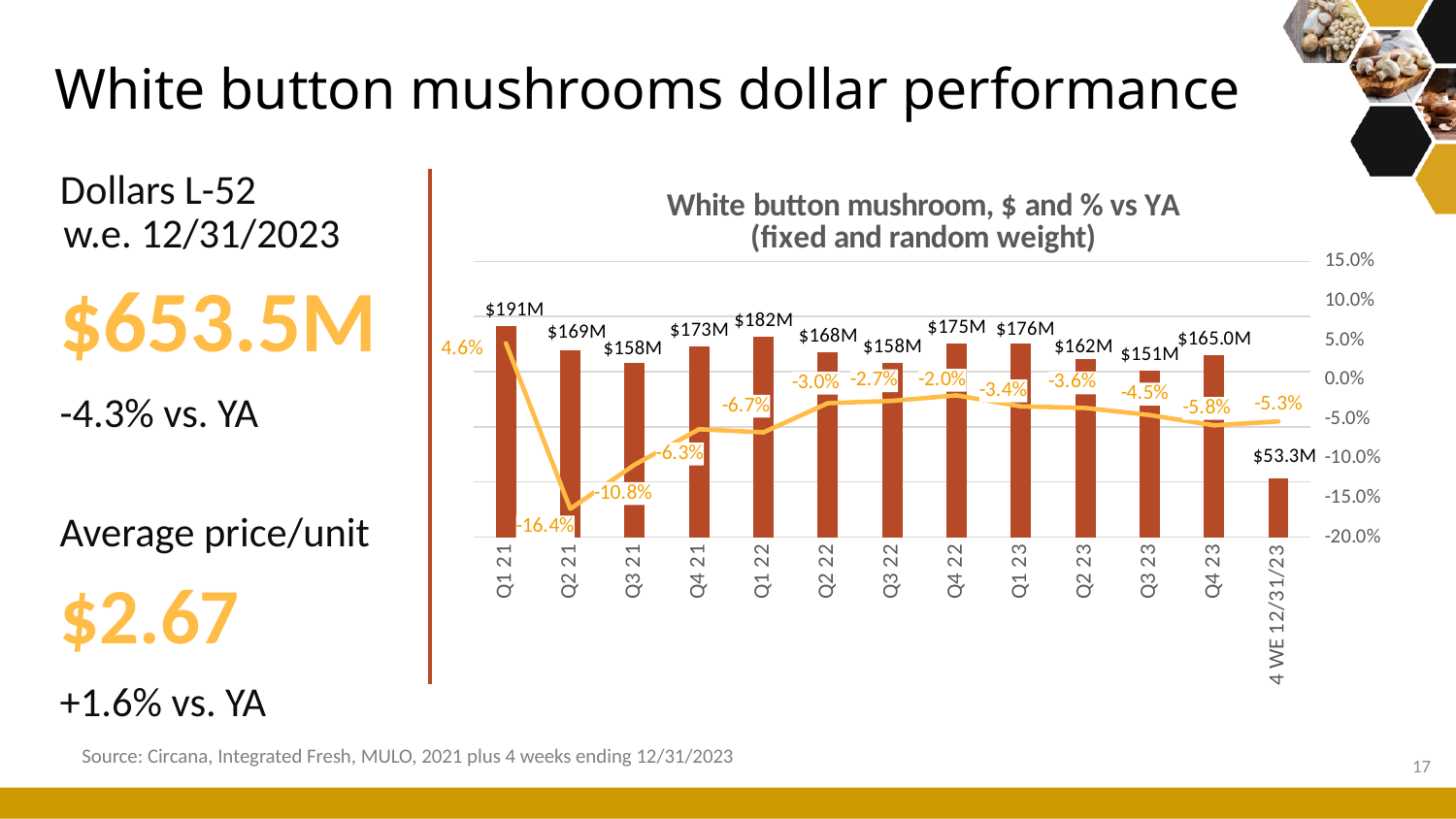
Which period has the highest dollar bar? Q1 21 Does the % vs YA line rise or fall from Q2 21 to Q4 22? Rises What is the difference in dollars between Q1 22 and Q2 22? $14M How many periods are shown on the x axis? 13 What is the % vs YA value for Q2 21? -16.4% What is the dollar value for Q4 23? $165.0M What is the % vs YA value for Q1 21? 4.6% Which period has the lowest dollar bar? 4 WE 12/31/23 What is the dollar value for the 4 WE 12/31/23 bar? $53.3M What is the dollar value for Q1 21? $191M Which has the larger dollar value, Q4 21 or Q1 22? Q1 22 What kind of chart is this? Combination bar and line chart